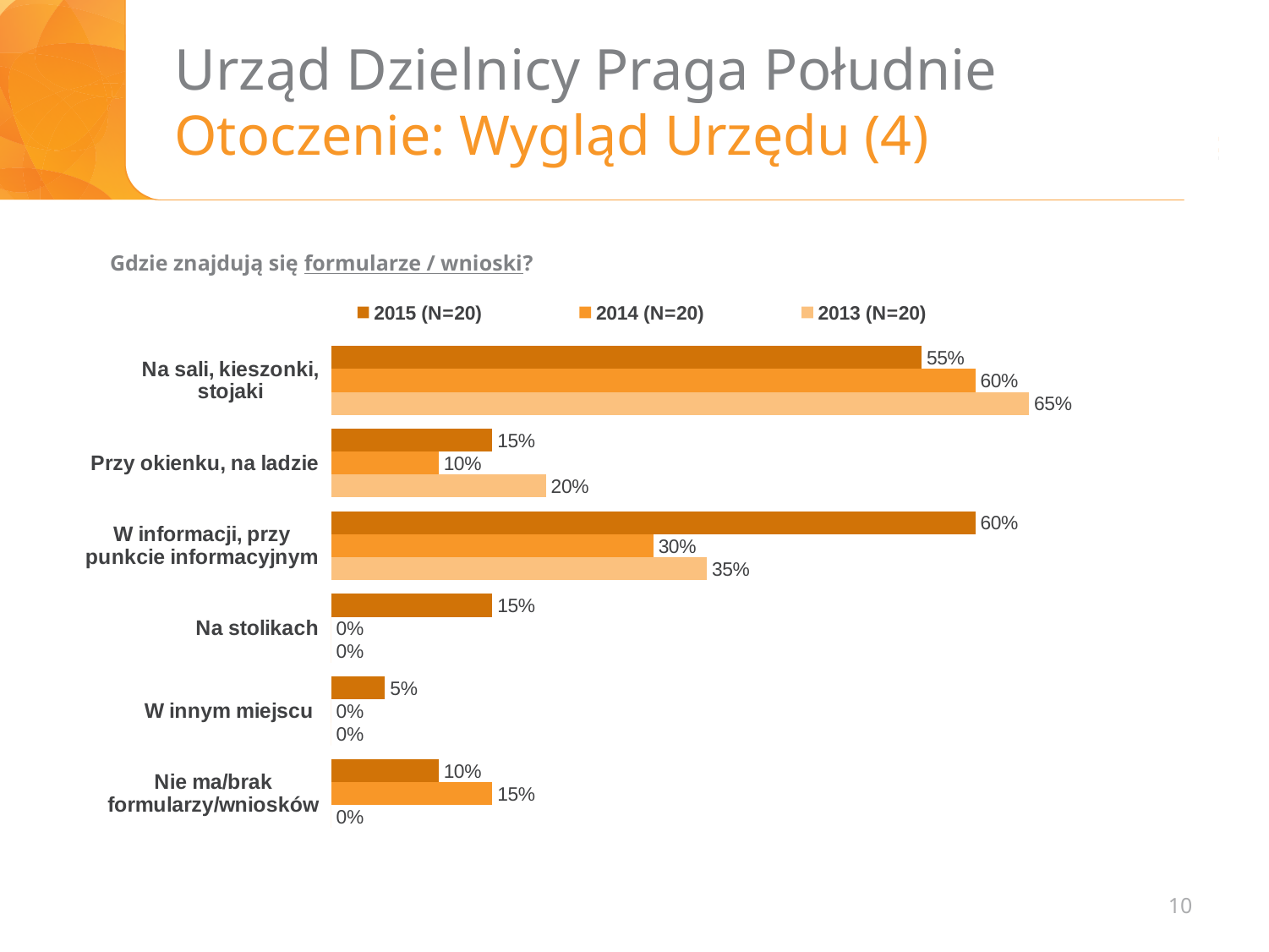
What kind of chart is shown on the slide? Bar chart How many categories are shown on the chart? 6 What is the difference between the 2013 (N=20) and 2015 (N=20) values for "Na sali, kieszonki, stojaki"? 10% How many series does the legend list? 3 What is the value for "Nie ma/brak formularzy/wniosków" in the 2014 (N=20) series? 15% Which category has the highest value in the 2015 (N=20) series? W informacji, przy punkcie informacyjnym What is the value for "Na sali, kieszonki, stojaki" in the 2015 (N=20) series? 55% What is the value for "W informacji, przy punkcie informacyjnym" in the 2014 (N=20) series? 30% What is the value for "Przy okienku, na ladzie" in the 2013 (N=20) series? 20% What is the difference between the 2015 (N=20) and 2014 (N=20) values for "W informacji, przy punkcie informacyjnym"? 30% Which is larger for "Przy okienku, na ladzie": the 2015 (N=20) value or the 2014 (N=20) value? 2015 (N=20) Which category has the lowest value in the 2015 (N=20) series? W innym miejscu